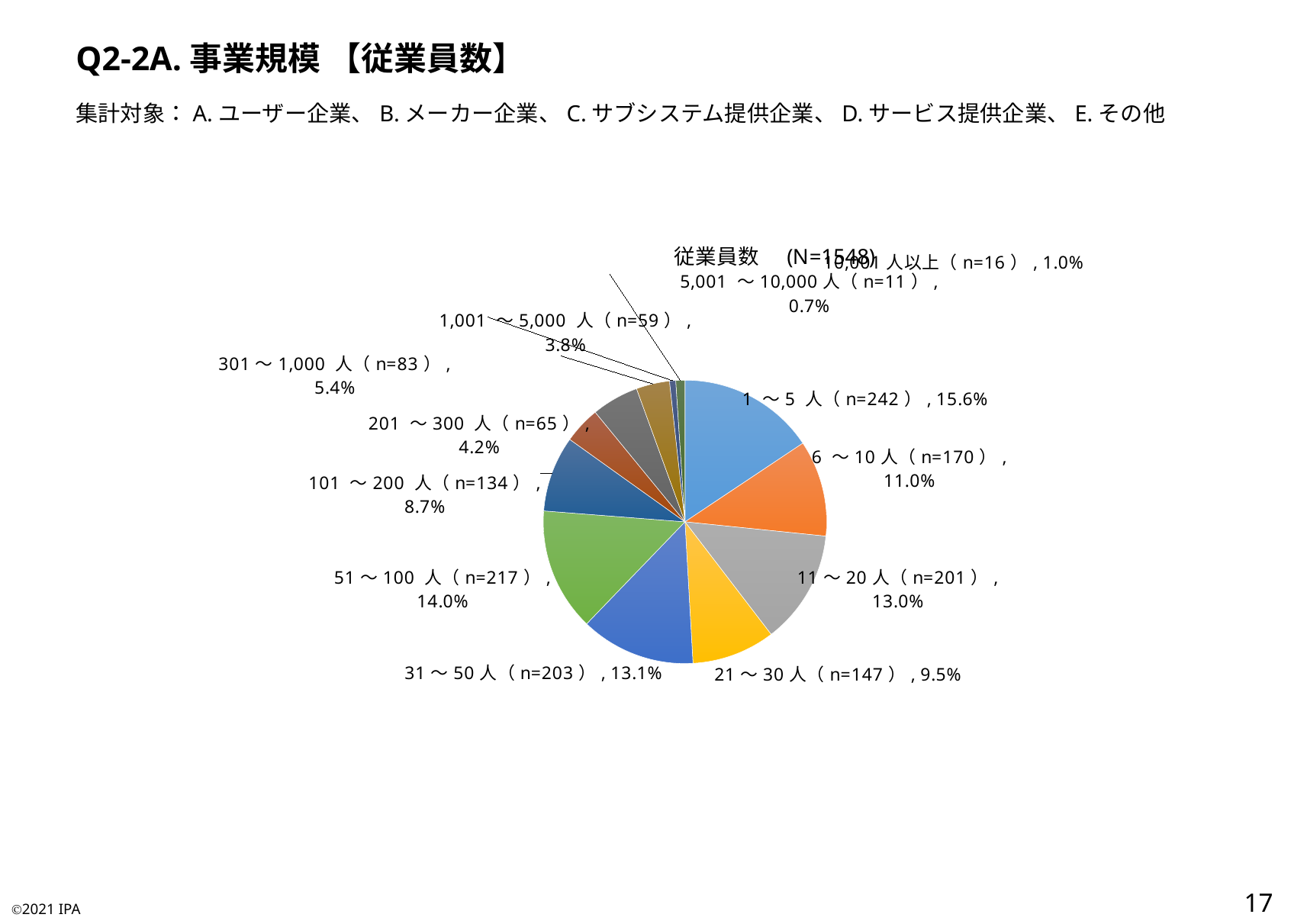
Which has the larger share, 6～10人 or 11～20人? 11～20人 How many slices does the pie chart have? 12 What is the title of the pie chart? 従業員数 (N=1548) What is the n value for the 301～1,000人 category? 83 Which category has the largest share of the pie? 1～5人 What is the n value for the 51～100人 category? 217 What is the difference in n between the 31～50人 category (n=203) and the 21～30人 category (n=147)? 56 What kind of chart is shown on the slide? pie chart Which category has the smallest share of the pie? 5,001～10,000人 What percentage share does the 101～200人 category have? 8.7% What percentage share does the 1～5人 category have? 15.6% What percentage share does the 1,001～5,000人 category have? 3.8%